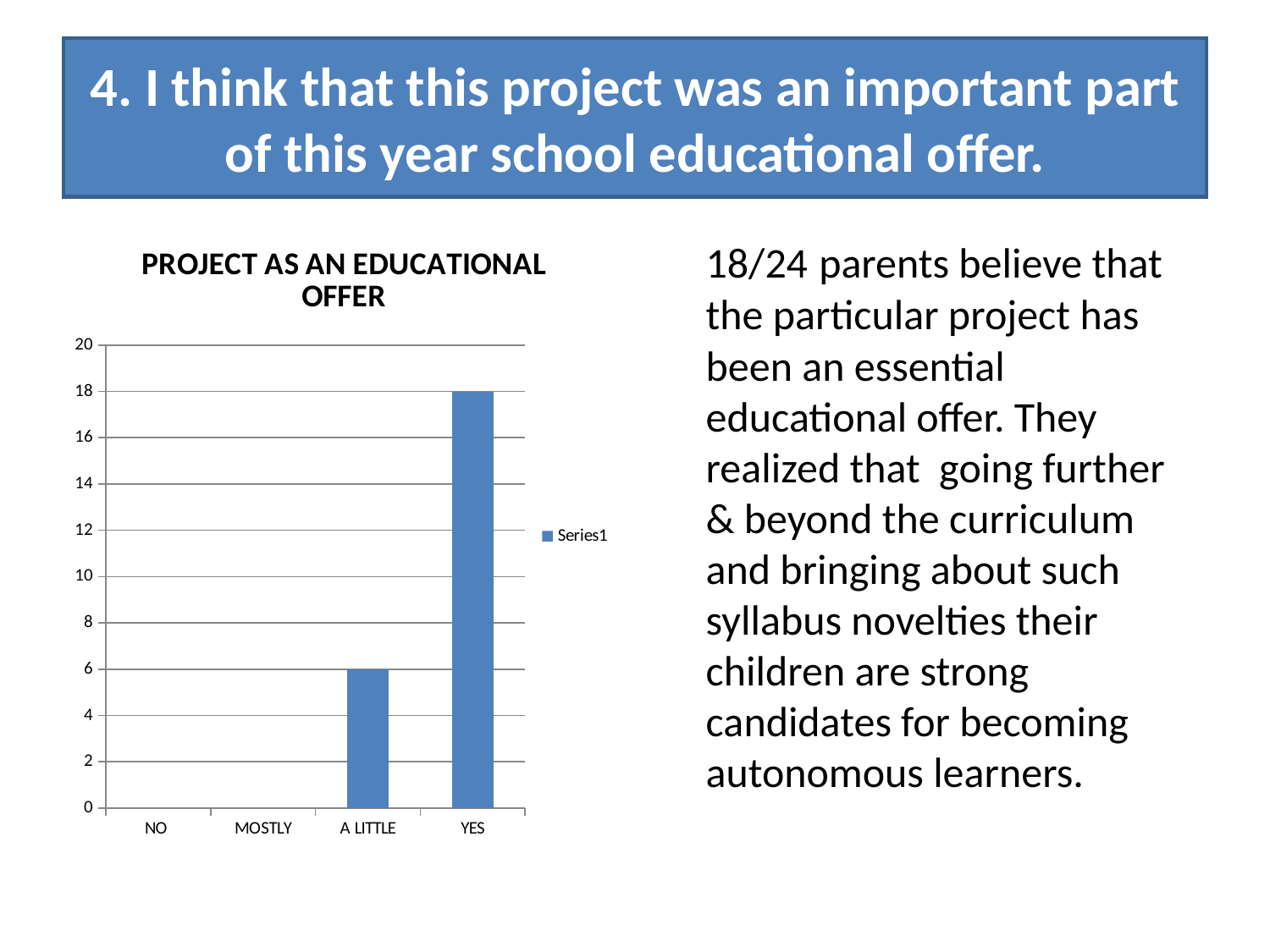
Is the value for YES greater or less than 10? greater Which category has the highest value in the chart? YES What is the value for YES in the chart? 18 What is the title of the chart? PROJECT AS AN EDUCATIONAL OFFER How many series does the chart legend list? 1 What kind of chart is shown on the slide? bar chart What is the name of the series shown in the chart legend? Series1 Which is larger, the value for A LITTLE or the value for YES? YES What is the value for A LITTLE in the chart? 6 How many categories are shown on the x axis of the chart? 4 Is the value for A LITTLE greater or less than 10? less What is the difference between the values for YES and A LITTLE? 12